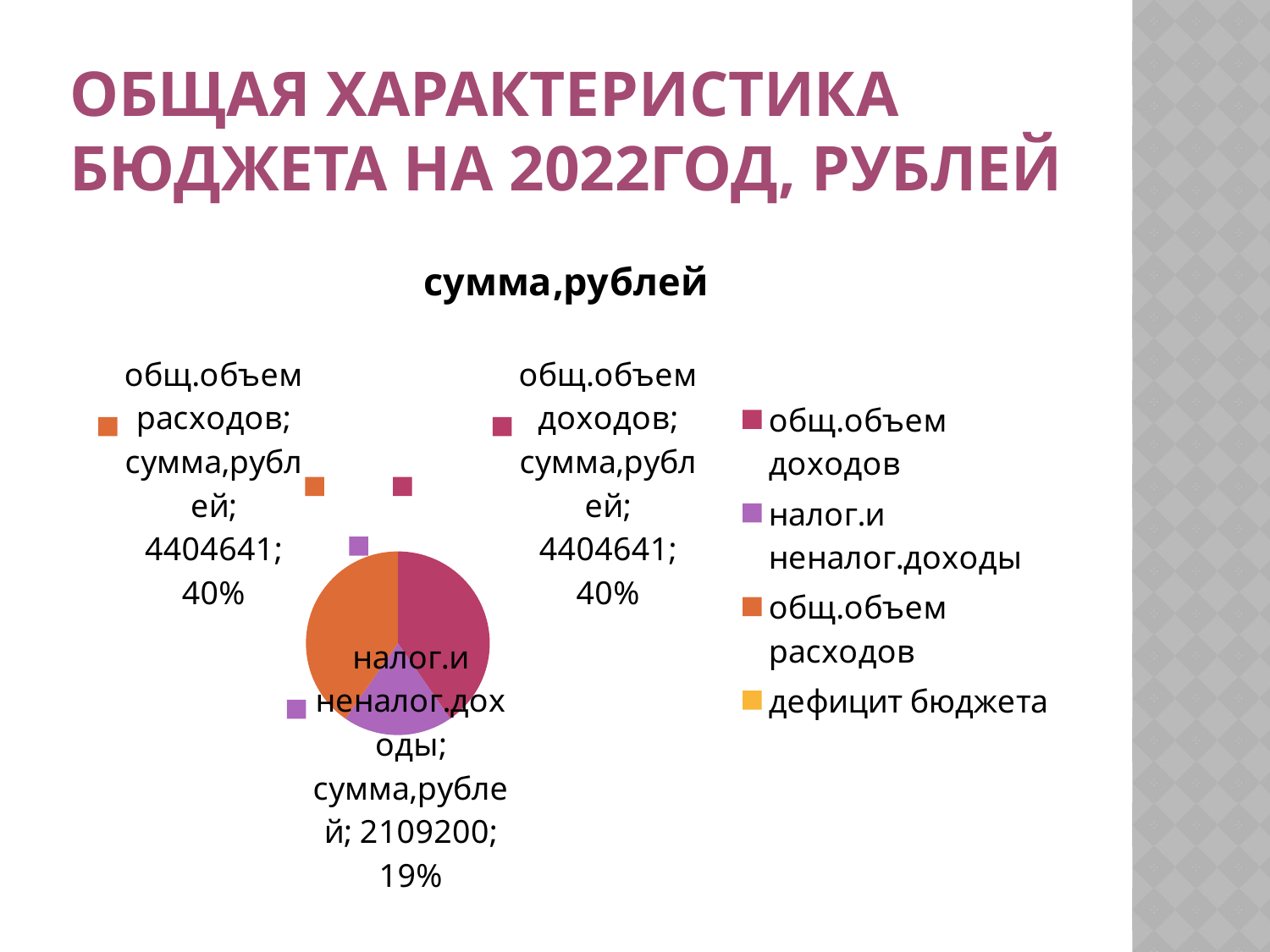
What is the value for налог.и неналог.доходы? 2109200 What share of the pie does налог.и неналог.доходы represent? 19% What share of the pie does общ.объем расходов represent? 40% What kind of chart is shown on the slide? pie chart What share of the pie does общ.объем доходов represent? 40% What is the value for общ.объем расходов? 4404641 What is the value for общ.объем доходов? 4404641 Which legend entry is shown in yellow? дефицит бюджета What is the title of the chart? сумма,рублей How many entries does the chart legend list? 4 What is the difference between the value for общ.объем доходов and the value for налог.и неналог.доходы? 2295441 Which is larger, the value for общ.объем расходов or the value for налог.и неналог.доходы? общ.объем расходов